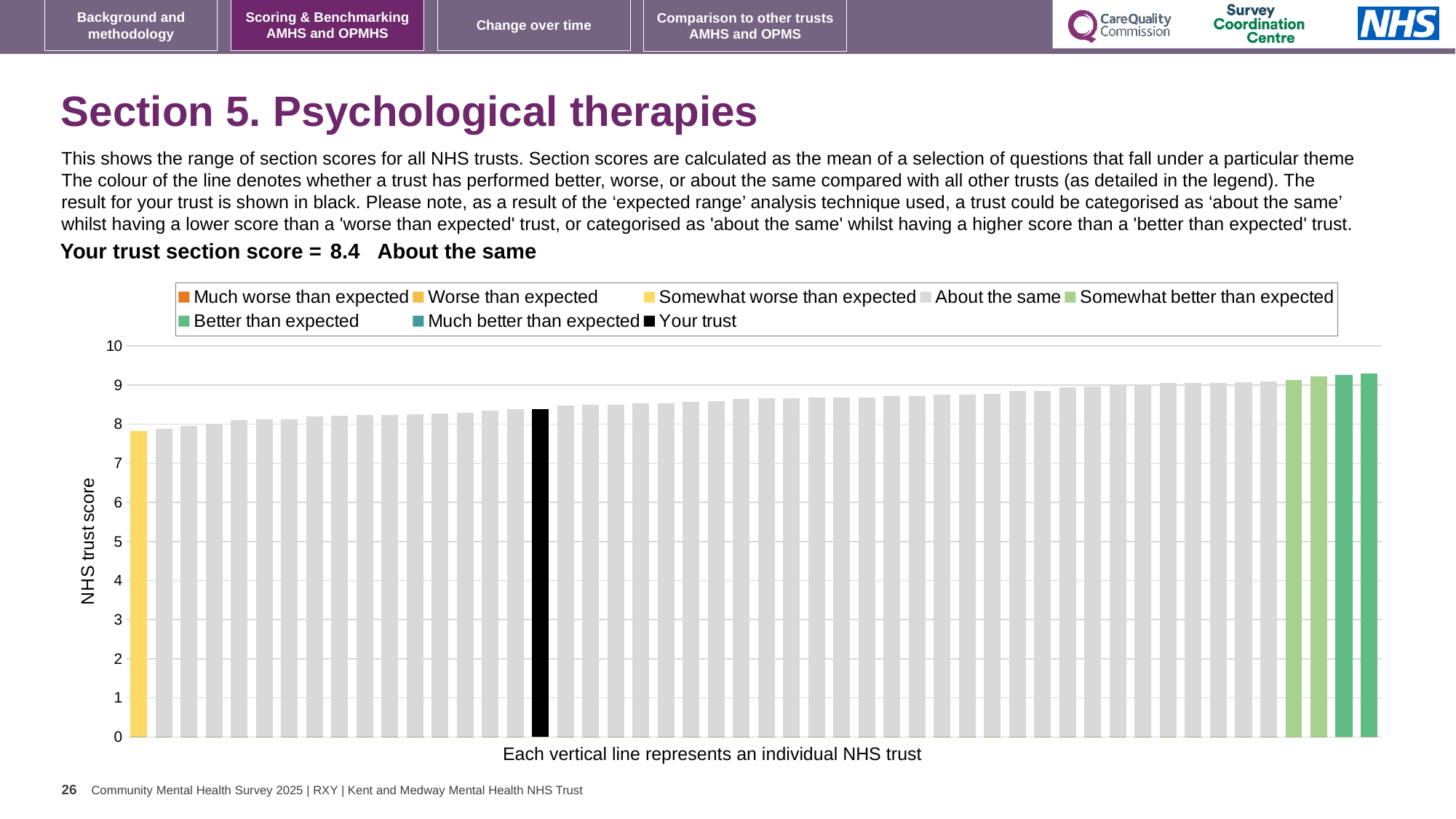
What is the label on the vertical axis of the chart? NHS trust score Do the bar values rise or fall from left to right across the chart? rise Which benchmarking category is your trust placed in for this section? About the same Which is higher, the rightmost bar or the black 'Your trust' bar? The rightmost bar How many bars are shown in green shades (somewhat better or better than expected)? 4 Is the value of the rightmost bar greater or less than 9? greater What is the section score for your trust shown on the slide? 8.4 Is the value of the black 'Your trust' bar greater or less than 9? less How many bars are coloured yellow ('Somewhat worse than expected')? 1 What kind of chart is shown on the slide? Bar chart How many entries does the chart legend list? 8 Is the value of the leftmost (yellow) bar greater or less than 8? less